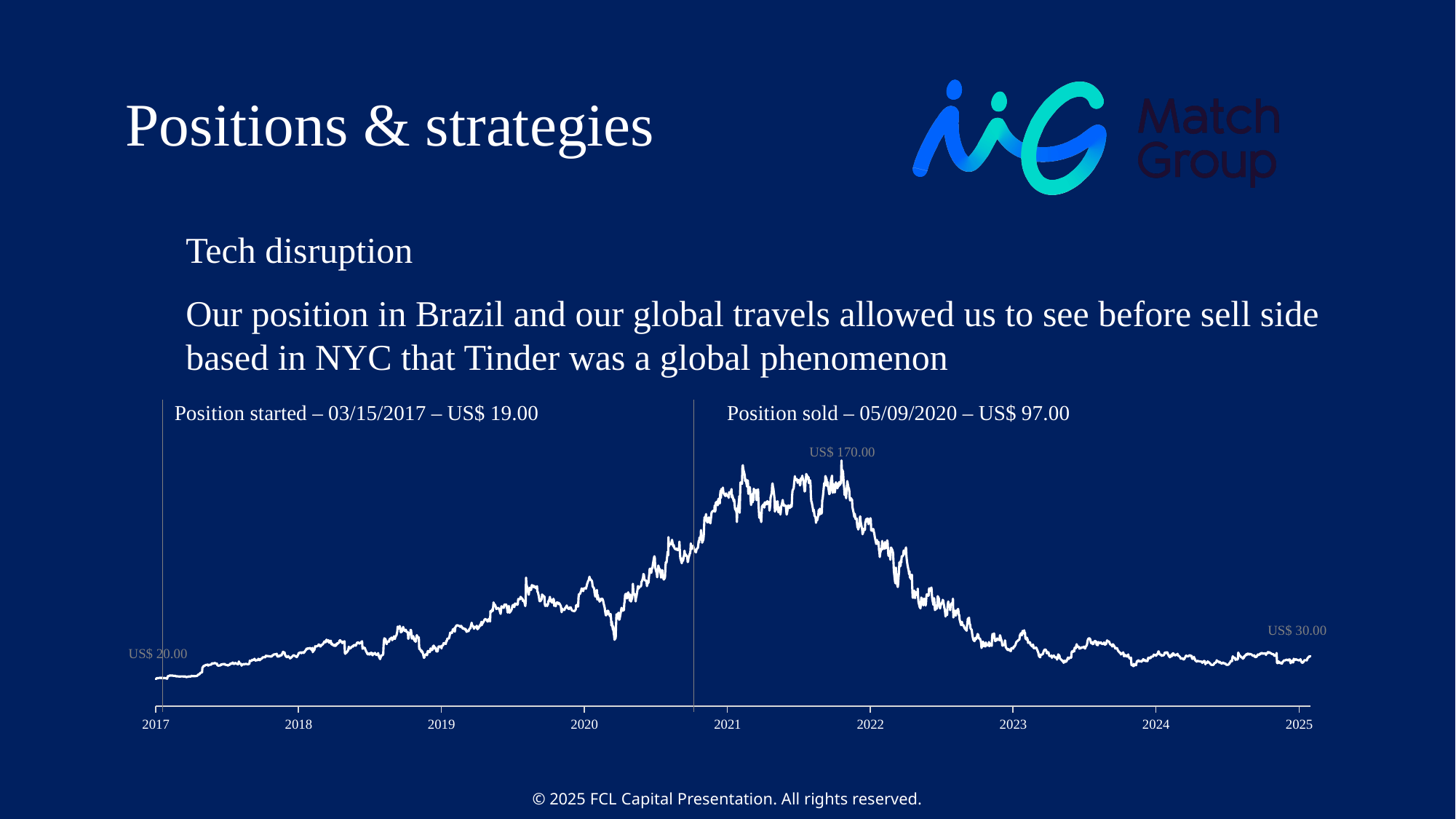
What price is labelled at the start of the line in 2017? US$ 20.00 What kind of chart is shown on the slide? line chart Does the line rise or fall between 2022 and 2023? fall What is the difference between the labelled peak price and the labelled 2025 end price? US$ 140.00 On what date was the position started according to the annotation? 03/15/2017 At what price was the position sold according to the annotation? US$ 97.00 Which is larger, the labelled price at the start of the line or the labelled price at the end of the line? the end (US$ 30.00) What is the difference between the position sold price and the position started price? US$ 78.00 At what price was the position started according to the annotation? US$ 19.00 How many year labels are shown on the x axis? 9 What price is labelled at the peak of the line? US$ 170.00 What price is labelled at the end of the line in 2025? US$ 30.00